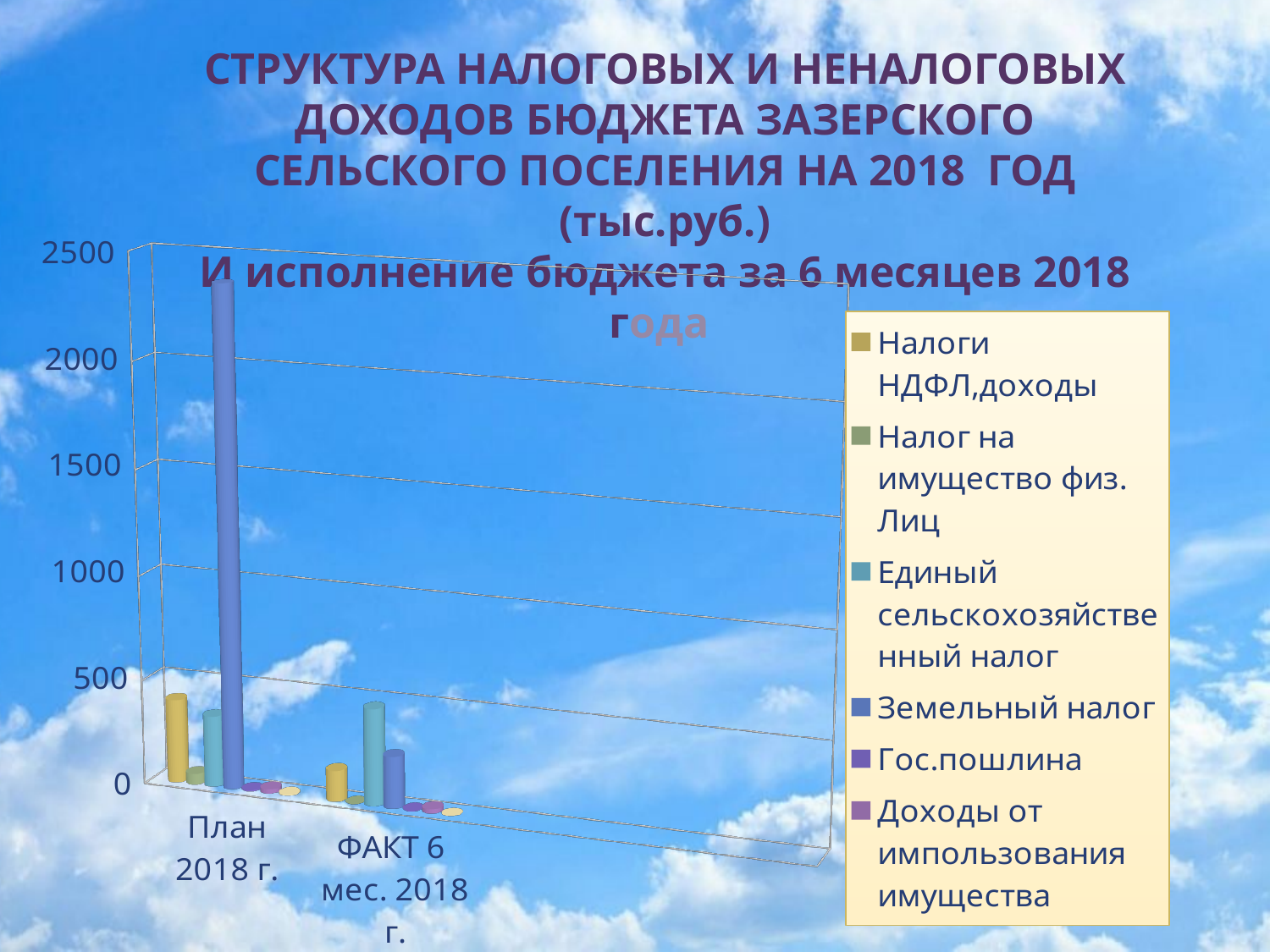
What colour represents "Земельный налог" in the legend? blue What is the highest value shown on the vertical axis of the chart? 2500 Is the value of "Земельный налог" for "ФАКТ 6 мес. 2018 г." greater or less than 500? less What kind of chart is shown on the slide? bar chart Which series has the highest value in the "ФАКТ 6 мес. 2018 г." category? Единый сельскохозяйственный налог Is the value of "Земельный налог" for "План 2018 г." greater or less than 2000? greater Does the value of "Земельный налог" rise or fall from "План 2018 г." to "ФАКТ 6 мес. 2018 г."? fall Which series has the highest value in the "План 2018 г." category? Земельный налог Is the value of "Земельный налог" for "ФАКТ 6 мес. 2018 г." greater or less than 1000? less Which is larger: "Земельный налог" for "План 2018 г." or "Земельный налог" for "ФАКТ 6 мес. 2018 г."? План 2018 г. How many categories are shown on the x axis of the chart? 2